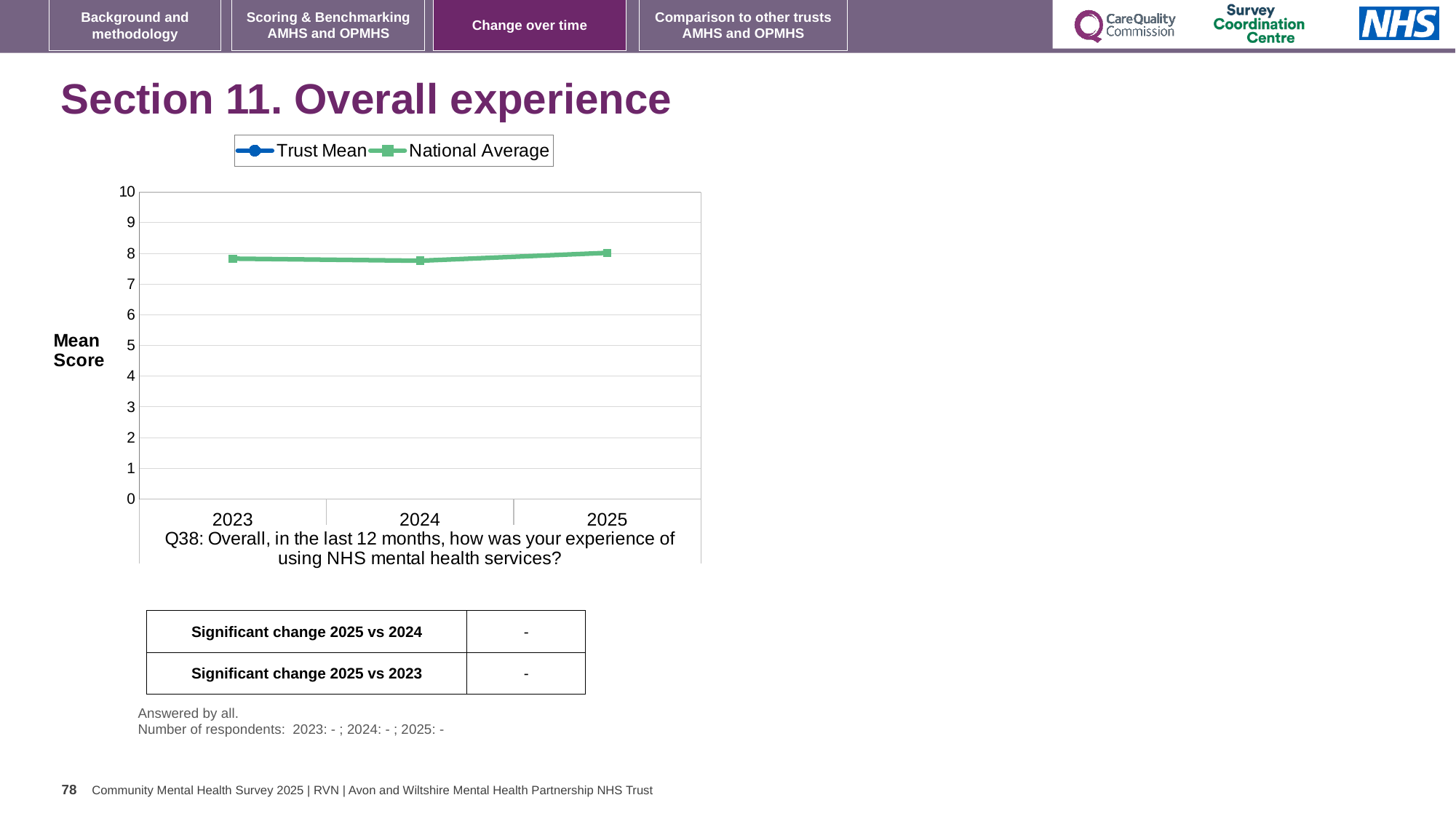
Is the National Average value for 2025 greater or less than 7? greater Does the National Average line rise or fall between 2024 and 2025? rise How many years are shown on the x axis? 3 How many series does the legend list? 2 What is the maximum value shown on the vertical axis? 10 Is the National Average value for 2024 greater or less than 6? greater What kind of chart is shown on the slide? line chart Which is larger for the National Average, the value for 2025 or the value for 2024? 2025 Which two series are listed in the legend? Trust Mean and National Average What is the label on the vertical axis? Mean Score Is the National Average value for 2023 greater or less than 7? greater